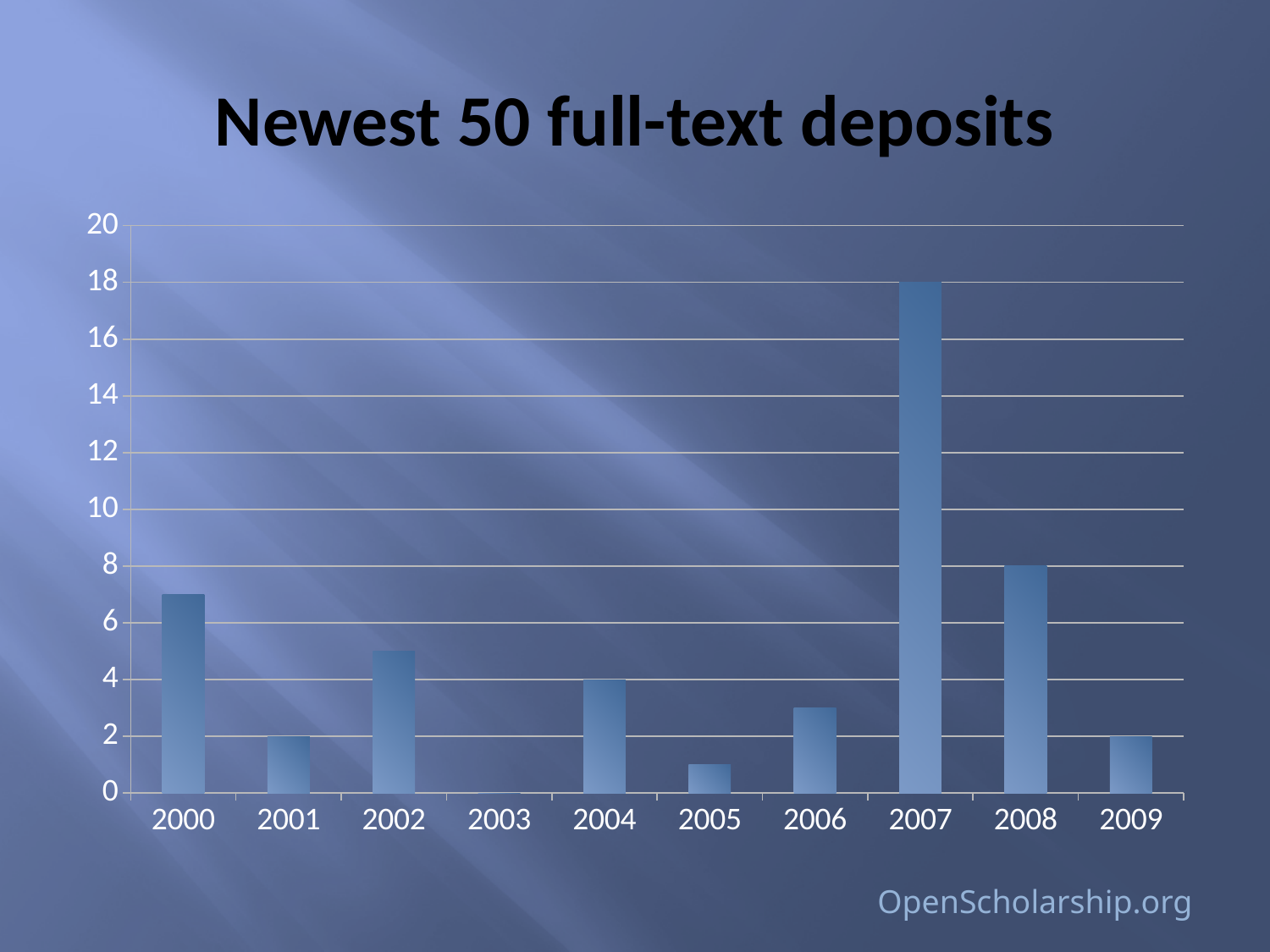
What is the value for 2008? 8 What is the value for 2009? 2 What is the difference between the values for 2007 and 2008? 10 What is the value for 2004? 4 How many years are shown on the x axis of the chart? 10 What is the title of the chart? Newest 50 full-text deposits What type of chart is shown on the slide? bar chart Which is larger, the value for 2000 or the value for 2002? 2000 Which year has the highest number of deposits? 2007 Is the value for 2000 greater or less than 6? greater Which year has the lowest number of deposits? 2003 What is the value for 2007? 18